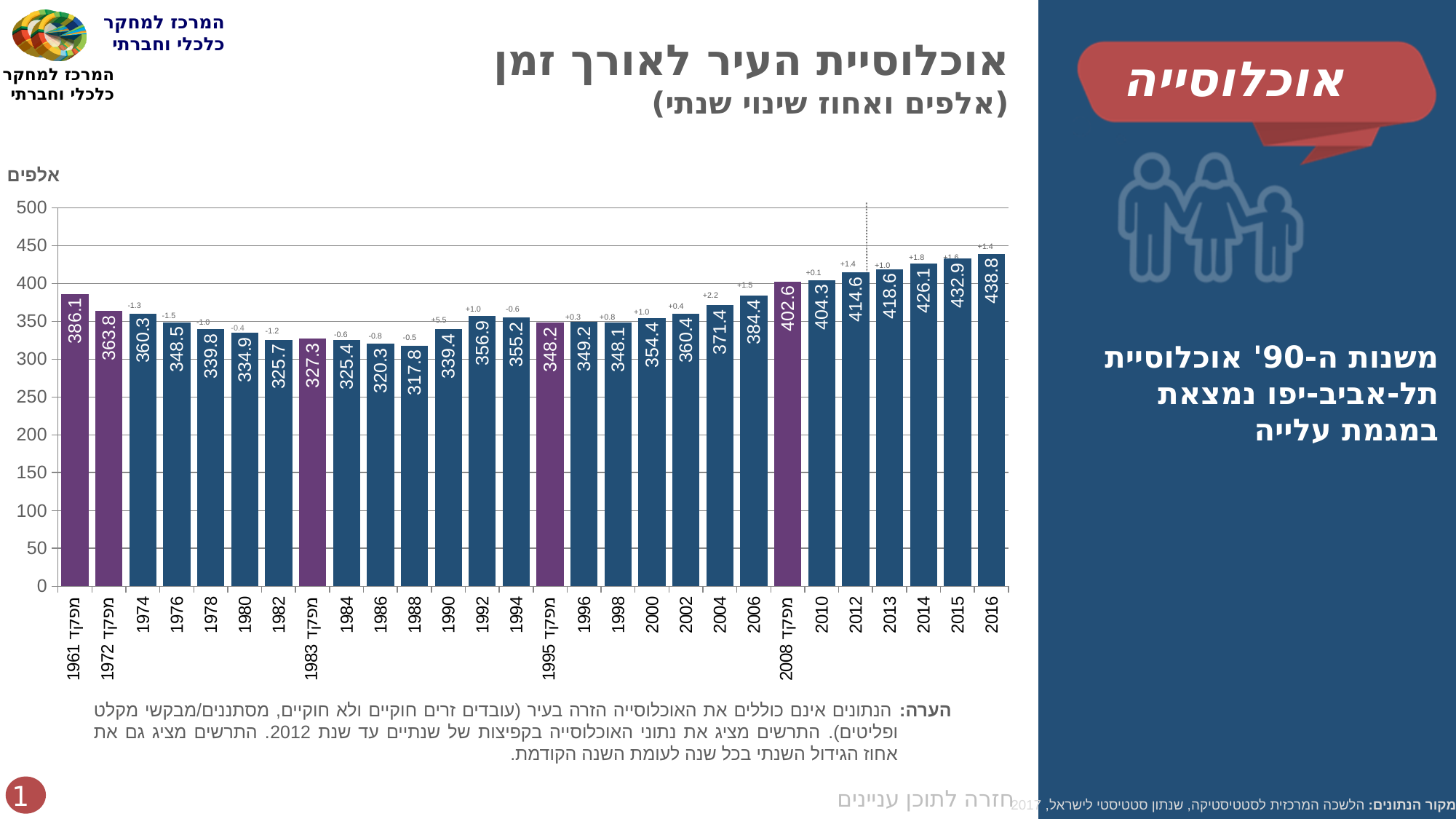
Which year has the lowest population value in the chart? 1988 What is the population value shown for 2016? 438.8 What is the difference between the population values for 1961 and 1972? 22.3 What type of chart is shown on the slide? bar chart What is the difference between the population values for 2016 and 2015? 5.9 Is the value for 2008 greater or less than 400? greater Which is larger, the population value for 1992 or for 1994? 1992 How many bars (years) are shown in the chart? 28 What is the population value shown for 1988? 317.8 What is the value shown for the 1961 census bar (מפקד 1961)? 386.1 Do the population values rise or fall from 1988 to 2016? rise Which year has the highest population value in the chart? 2016